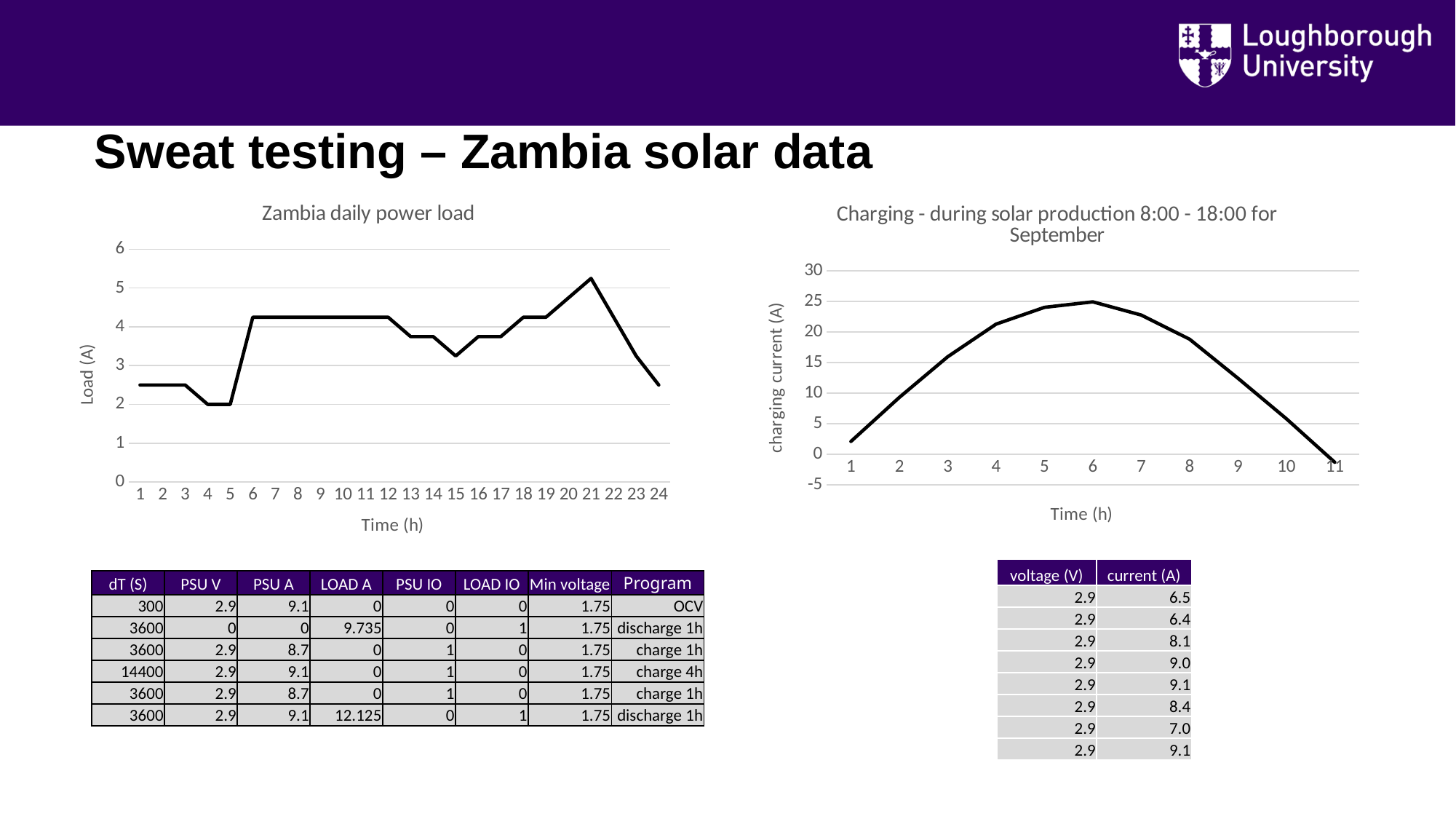
In the 'Charging - during solar production 8:00 - 18:00 for September' chart, does the charging current rise or fall between hour 6 and hour 11? fall In the 'Charging - during solar production 8:00 - 18:00 for September' chart, how many time points are plotted along the x axis? 11 In the 'Charging - during solar production 8:00 - 18:00 for September' chart, is the charging current at hour 9 greater or less than 10? greater In the 'Zambia daily power load' chart, is the load at hour 21 greater or less than 5? greater What kind of chart is the 'Charging - during solar production 8:00 - 18:00 for September' chart? line chart What kind of chart is the 'Zambia daily power load' chart? line chart In the 'Charging - during solar production 8:00 - 18:00 for September' chart, at which hour is the charging current lowest? 11 In the 'Zambia daily power load' chart, at which hour is the load highest? 21 In the 'Charging - during solar production 8:00 - 18:00 for September' chart, at which hour is the charging current highest? 6 In the 'Zambia daily power load' chart, how many time points are plotted along the x axis? 24 In the 'Zambia daily power load' chart, is the load at hour 15 greater or less than 4? less What is the y-axis label of the 'Charging - during solar production 8:00 - 18:00 for September' chart? charging current (A)